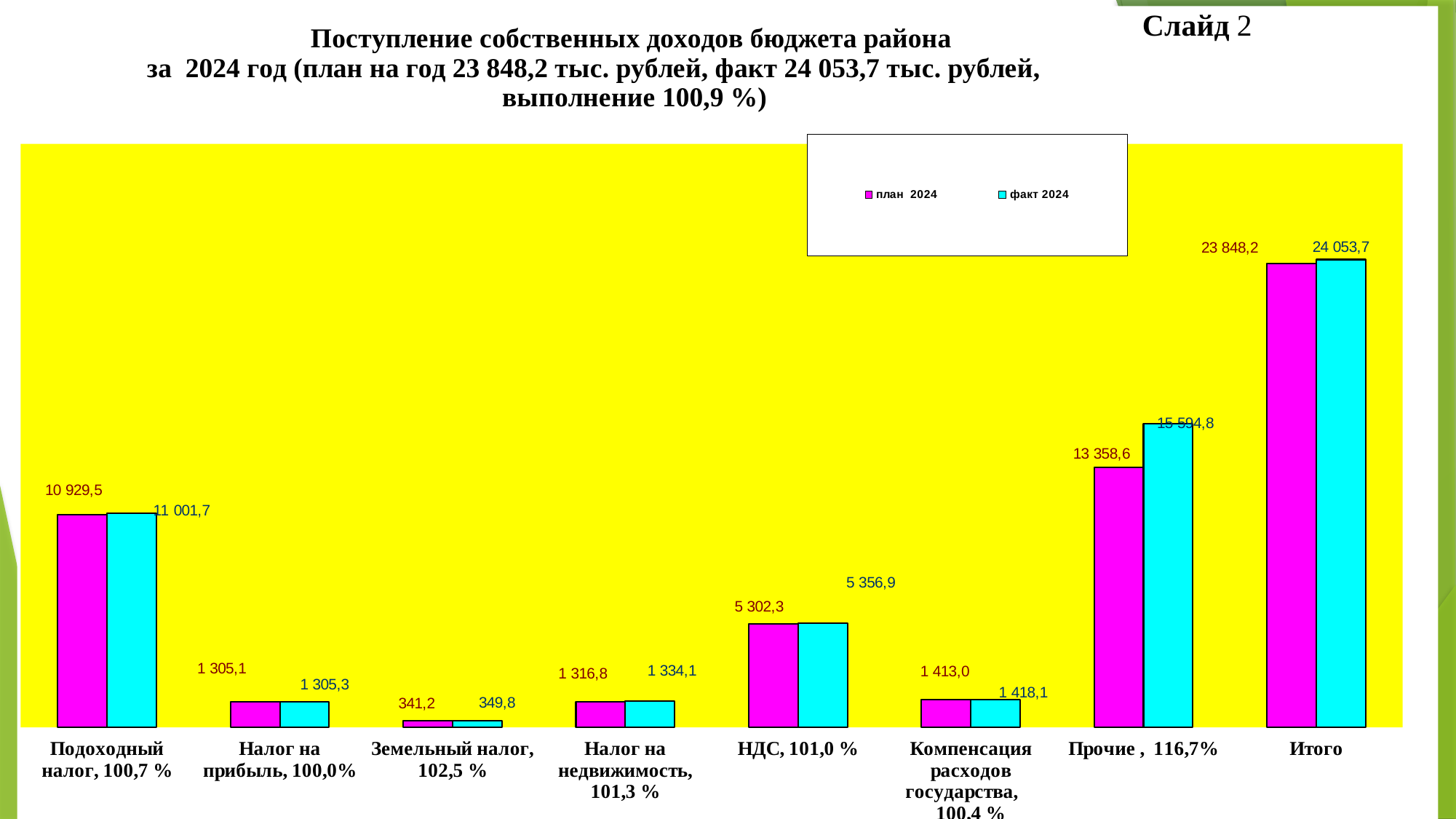
What is the факт 2024 value for Прочие? 15 594,8 What is the difference between the факт 2024 and план 2024 values for Итого? 205,5 What kind of chart is shown on the slide? bar chart How many categories are shown on the x axis? 8 Which is larger for Подоходный налог: the план 2024 value or the факт 2024 value? факт 2024 How many series does the legend list? 2 Which category has the highest план 2024 value? Итого What is the план 2024 value for Подоходный налог? 10 929,5 What is the факт 2024 value for НДС? 5 356,9 What is the difference between the факт 2024 and план 2024 values for Прочие? 2 236,2 What is the план 2024 value for Земельный налог? 341,2 Which category has the lowest факт 2024 value? Земельный налог